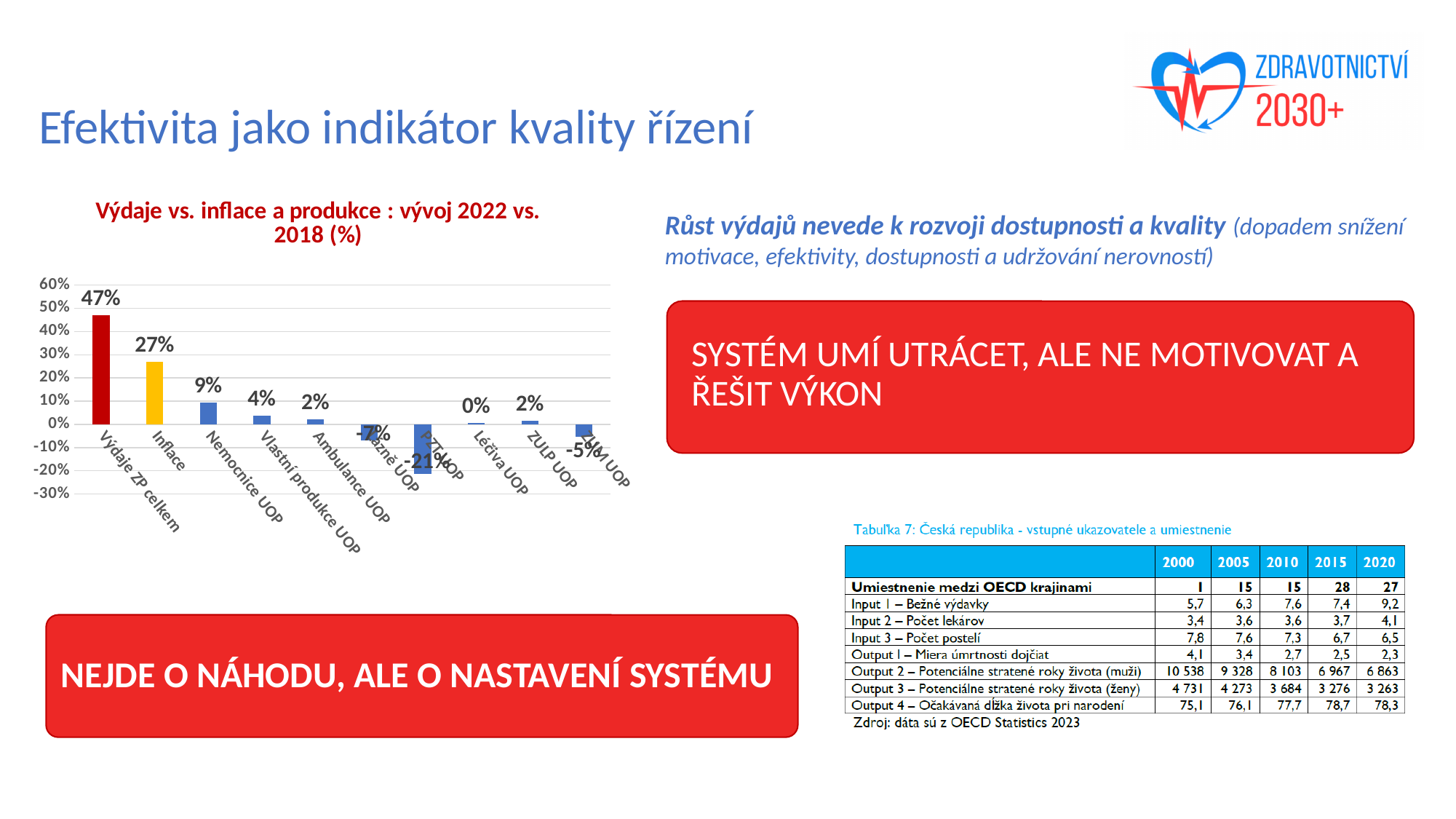
What is the difference between the values for Výdaje ZP celkem and Inflace in the bar chart? 20% What is the value for Vlastní produkce UOP in the bar chart? 4% Which category has the highest value in the bar chart? Výdaje ZP celkem What is the value for Léčiva UOP in the bar chart? 0% How many categories are plotted in the bar chart? 10 What is the lowest value shown in the bar chart? -21% What is the value for Nemocnice UOP in the bar chart? 9% What is the value for Inflace in the bar chart? 27% Which is larger in the bar chart, the value for Nemocnice UOP or the value for Ambulance UOP? Nemocnice UOP What type of chart is shown under the title 'Výdaje vs. inflace a produkce : vývoj 2022 vs. 2018 (%)'? Bar chart What is the value for Výdaje ZP celkem in the bar chart? 47% What colour is the bar for Inflace in the bar chart? Yellow